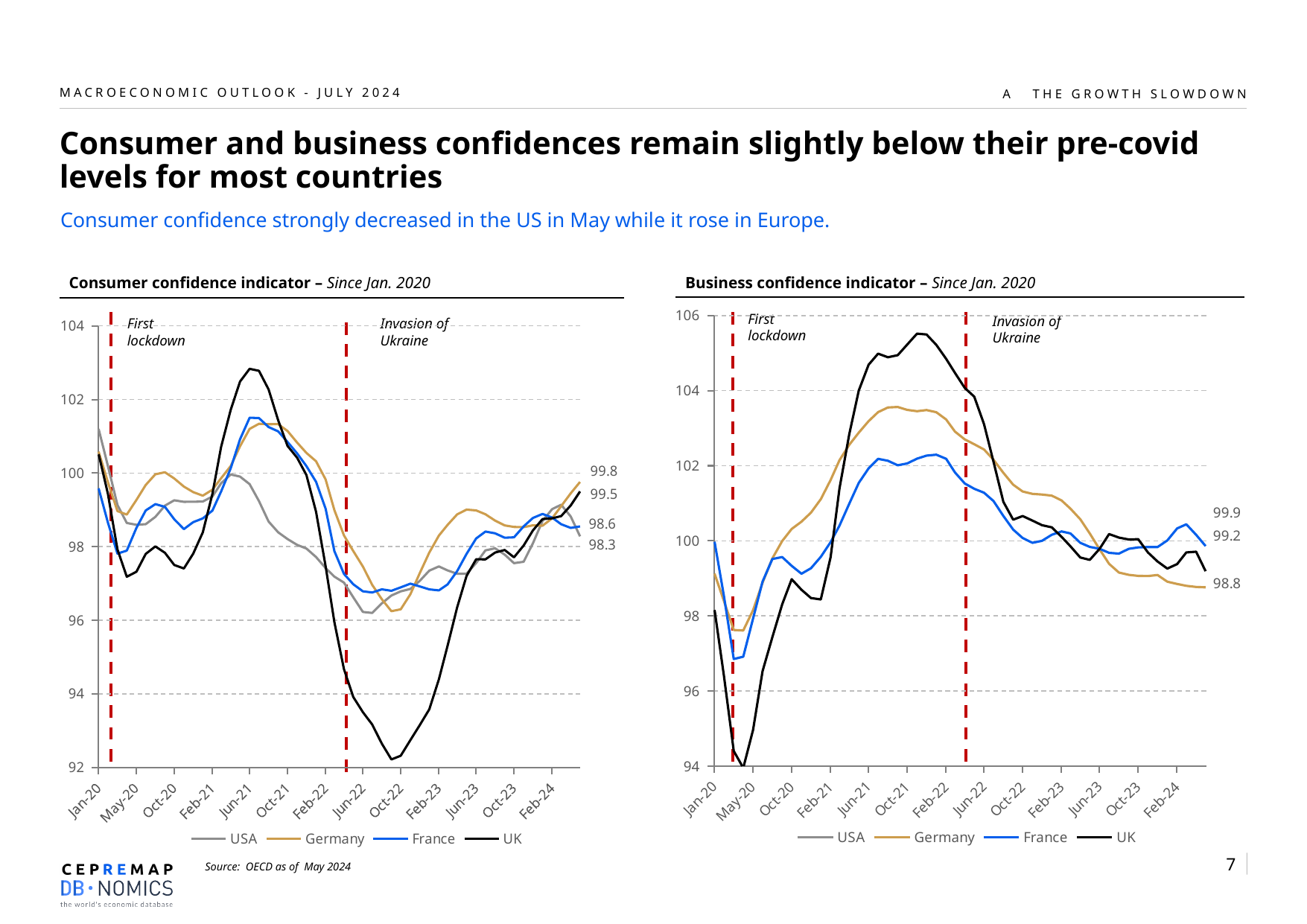
What two events do the red dashed vertical lines mark on the charts? First lockdown and Invasion of Ukraine How many series does the legend of the Business confidence indicator chart list? 4 In the Business confidence indicator chart, what is the latest value shown for France? 99.9 In the Consumer confidence indicator chart, what is the difference between the latest values for Germany and the UK? 0.3 In the Business confidence indicator chart, which country reaches the highest peak? UK In the Consumer confidence indicator chart, is the lowest value for the UK greater or less than 94? less In the Business confidence indicator chart, which is larger at the end of the series, France or Germany? France In the Consumer confidence indicator chart, what is the latest value shown for Germany? 99.8 In the Consumer confidence indicator chart, does the UK line rise or fall between Jun-21 and Oct-22? Fall What kind of chart is the Consumer confidence indicator chart? Line chart In the Business confidence indicator chart, what is the latest value shown for Germany? 98.8 In the Consumer confidence indicator chart, what is the latest value shown for the UK? 99.5